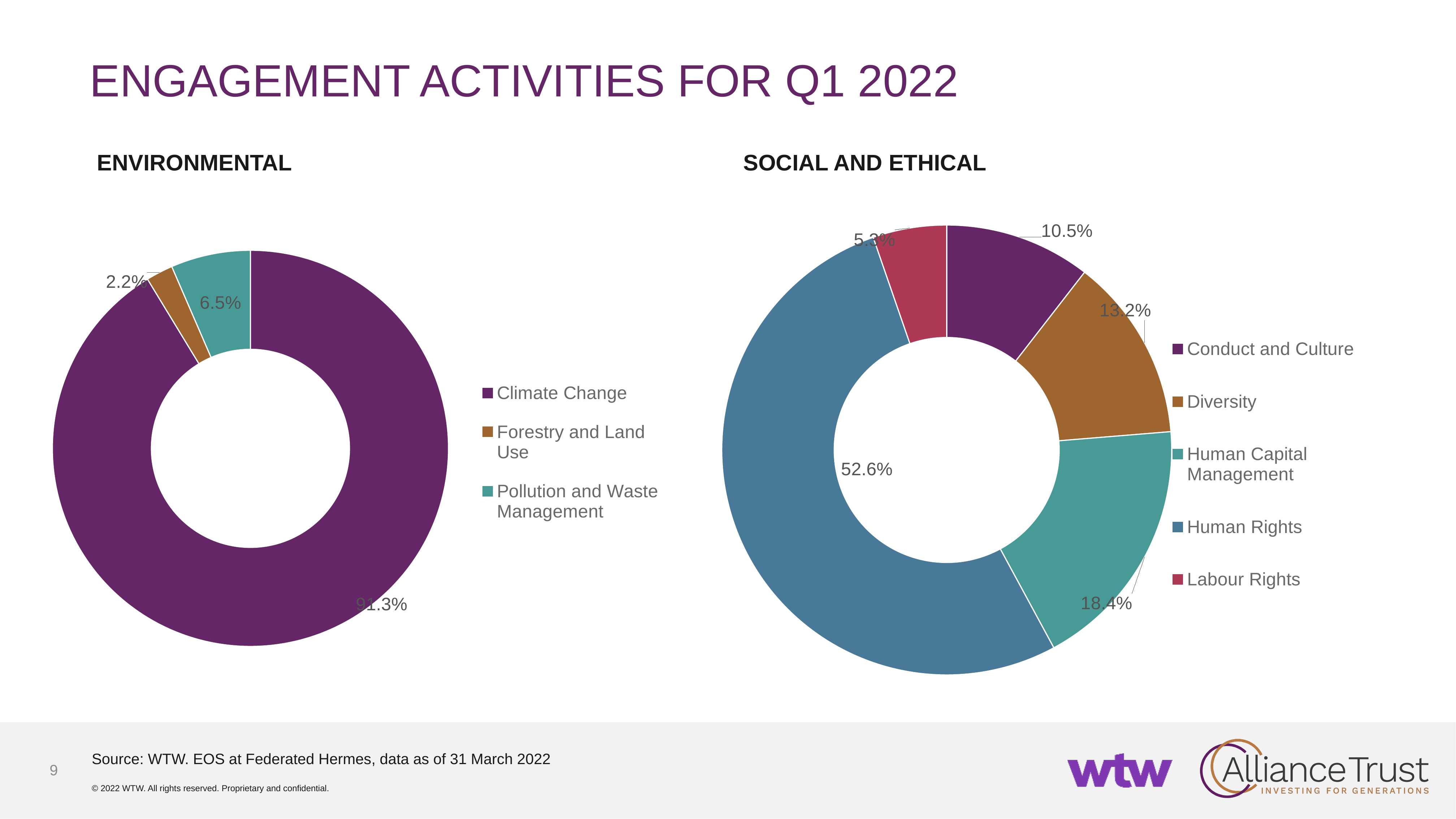
In the Environmental chart, how many categories does the legend list? 3 In the Social and Ethical chart, what share is labelled for Human Capital Management? 18.4% In the Environmental chart, which category has the smallest share? Forestry and Land Use In the Social and Ethical chart, which is larger, the share for Diversity or the share for Conduct and Culture? Diversity In the Social and Ethical chart, what is the difference between the shares for Human Capital Management and Conduct and Culture? 7.9% In the Social and Ethical chart, which category has the largest share? Human Rights In the Social and Ethical chart, what share is labelled for Diversity? 13.2% In the Environmental chart, what share is labelled for Climate Change? 91.3% What kind of chart is the Social and Ethical chart? Donut (pie) chart In the Social and Ethical chart, what share is labelled for Human Rights? 52.6% In the Environmental chart, what share is labelled for Pollution and Waste Management? 6.5% In the Environmental chart, what share is labelled for Forestry and Land Use? 2.2%